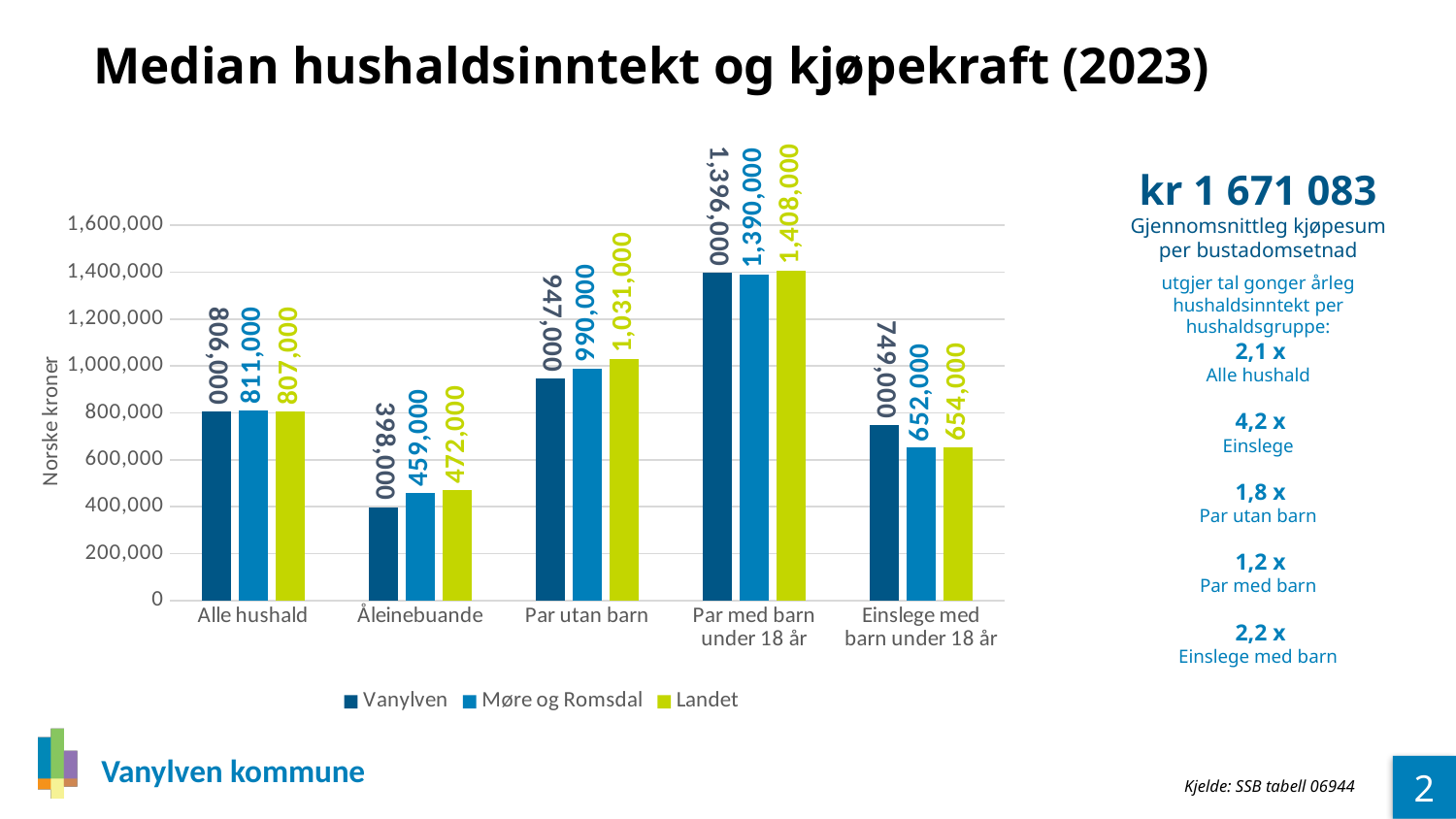
What is the difference between the Landet and Vanylven values in the Åleinebuande category? 74,000 What is the value for Møre og Romsdal in the Åleinebuande category? 459,000 In the Einslege med barn under 18 år category, which is larger: Vanylven or Møre og Romsdal? Vanylven How many categories are shown on the x axis? 5 What is the value for Vanylven in the Alle hushald category? 806,000 Which category has the highest value for Landet? Par med barn under 18 år What is the value for Vanylven in the Einslege med barn under 18 år category? 749,000 Which category has the lowest value for Vanylven? Åleinebuande What kind of chart is shown on the slide? Bar chart What is the label of the y axis? Norske kroner How many series does the legend list? 3 What is the value for Landet in the Par utan barn category? 1,031,000